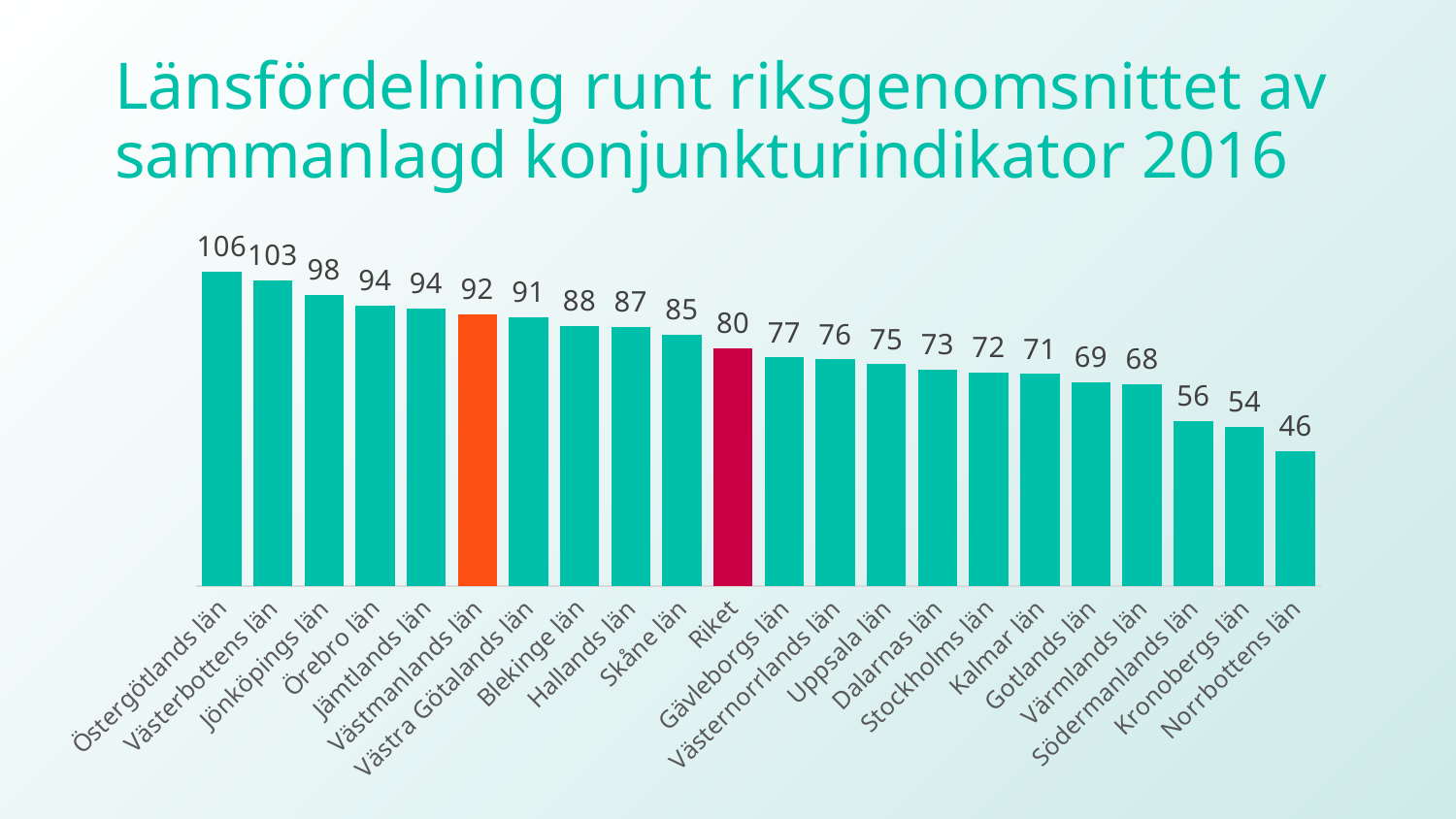
What is the difference between the values for Västmanlands län and Riket? 12 What kind of chart is shown on the slide? Bar chart What is the value for Riket? 80 What is the value for Stockholms län? 72 Which is larger, the value for Skåne län or the value for Gävleborgs län? Skåne län Which bar is coloured orange? Västmanlands län What is the difference between the values for Östergötlands län and Norrbottens län? 60 Which category has the lowest value? Norrbottens län How many bars are shown in the chart? 22 Do the values rise or fall from left to right along the x axis? Fall Which category has the highest value? Östergötlands län What is the value for Västmanlands län? 92